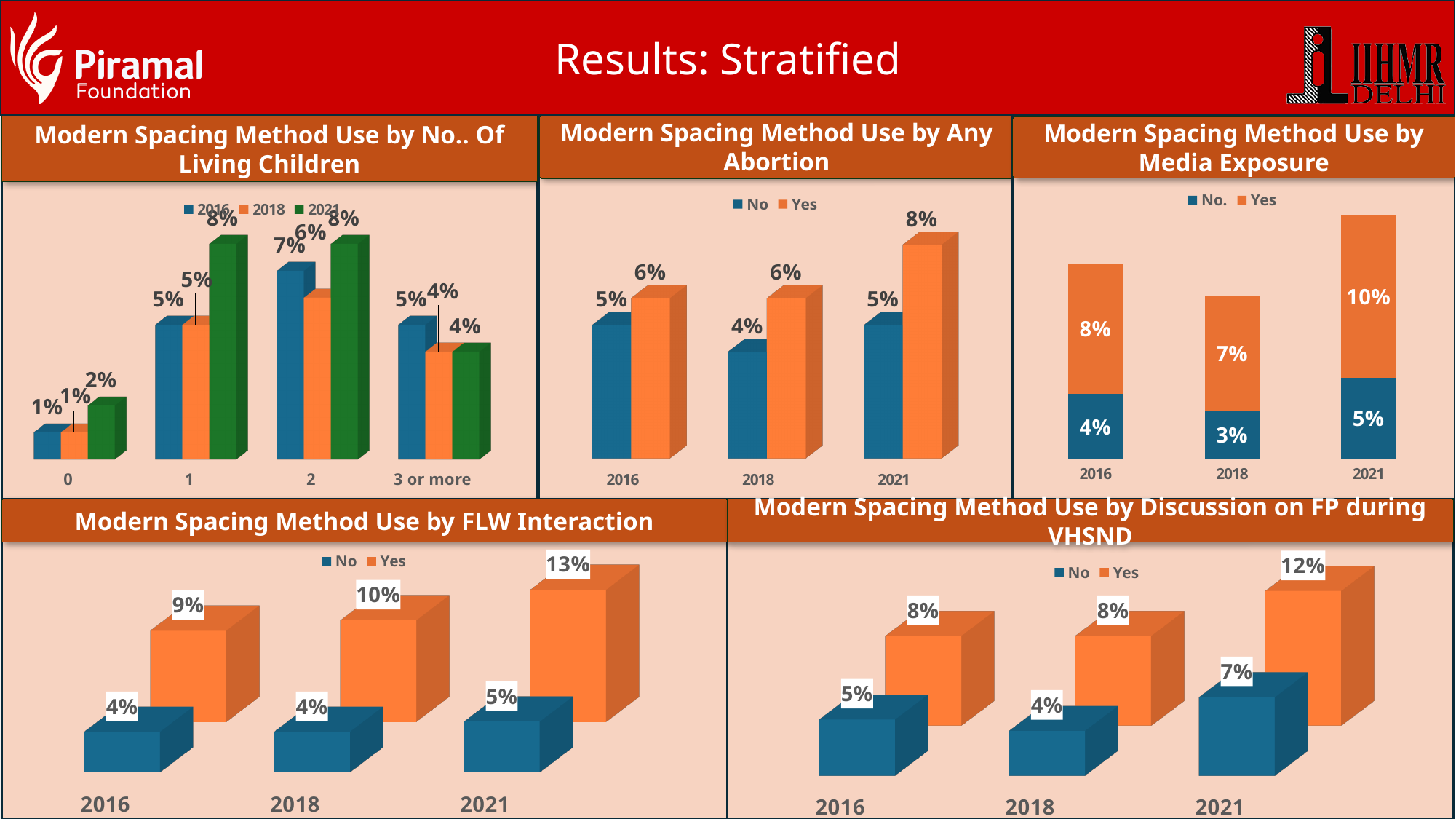
In the 'Modern Spacing Method Use by FLW Interaction' chart, which year has the highest 'Yes' value? 2021 In the 'Modern Spacing Method Use by Discussion on FP during VHSND' chart, what is the 'No' value for 2021? 7% What kind of chart is 'Modern Spacing Method Use by FLW Interaction'? Bar chart In the 'Modern Spacing Method Use by Media Exposure' chart, what is the 'No.' value for 2018? 3% In the 'Modern Spacing Method Use by No.. Of Living Children' chart, which category has the lowest 2016 value? 0 In the 'Modern Spacing Method Use by Any Abortion' chart, what is the 'Yes' value for 2021? 8% In the 'Modern Spacing Method Use by No.. Of Living Children' chart, how many series does the legend list? 3 In the 'Modern Spacing Method Use by Media Exposure' chart, what is the total of the stacked bar for 2021? 15% In the 'Modern Spacing Method Use by FLW Interaction' chart, what is the difference between the 'Yes' and 'No' values for 2021? 8% In the 'Modern Spacing Method Use by Any Abortion' chart, what is the difference between the 'Yes' and 'No' values for 2018? 2% In the 'Modern Spacing Method Use by No.. Of Living Children' chart, what is the 2021 value for 1 living child? 8% In the 'Modern Spacing Method Use by Discussion on FP during VHSND' chart, which is larger: the 'Yes' value for 2021 or the 'Yes' value for 2016? 2021